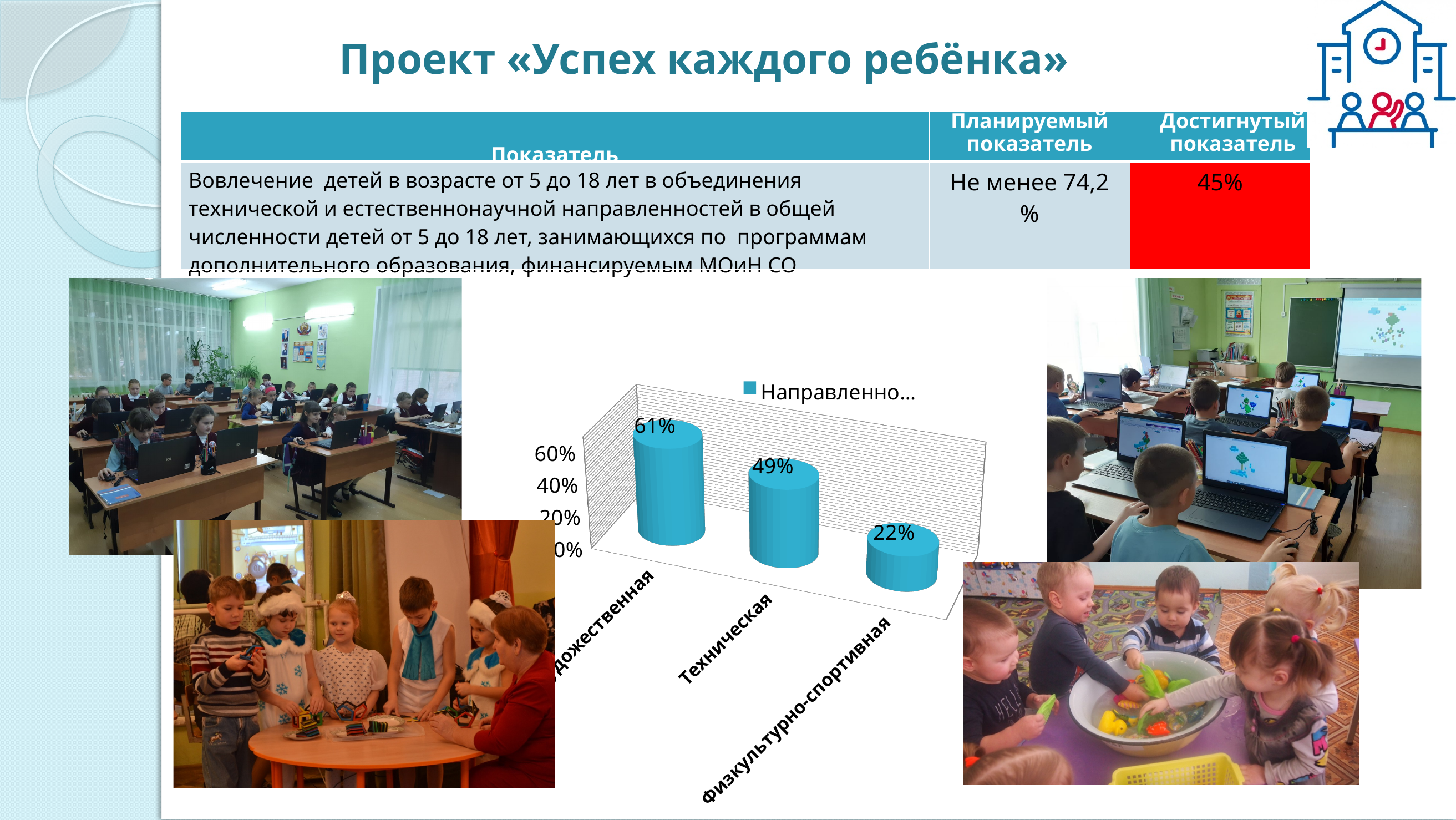
Do the bar values rise or fall from left to right across the chart? fall What is the value for Физкультурно-спортивная in the bar chart? 22% Which category has the lowest value in the bar chart? Физкультурно-спортивная How many series does the chart legend list? 1 What is the value for Техническая in the bar chart? 49% Is the value for Физкультурно-спортивная greater or less than 40%? less What is the value of the leftmost bar in the chart? 61% What type of chart is shown on the slide? bar chart Which is larger, the value for Техническая or the value for Физкультурно-спортивная? Техническая What is the difference between the values for Техническая and Физкультурно-спортивная? 27% How many bars are plotted in the chart? 3 Is the value for Техническая greater or less than 40%? greater